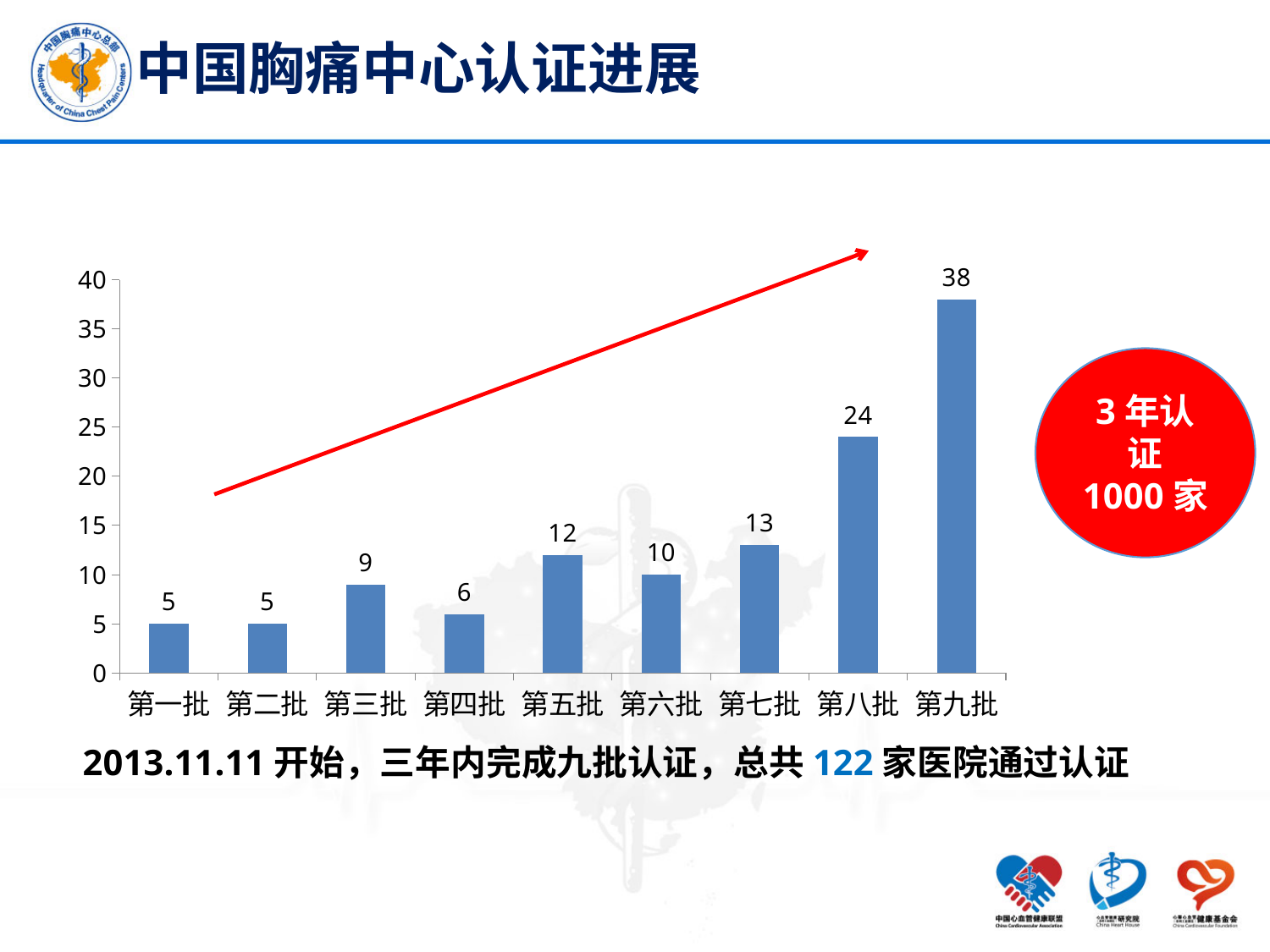
Do the values generally rise or fall from 第一批 to 第九批? rise Which batch has the highest value? 第九批 What is the value for 第四批? 6 Which is larger, the value for 第六批 or the value for 第七批? 第七批 Is the value for 第八批 greater or less than 20? greater What is the difference between the values for 第九批 and 第八批? 14 What is the lowest value shown on the chart? 5 What kind of chart is shown on the slide? bar chart How many batches (categories) are shown on the x axis? 9 What is the value for 第九批? 38 What is the value for 第五批? 12 What is the maximum value shown on the y axis? 40